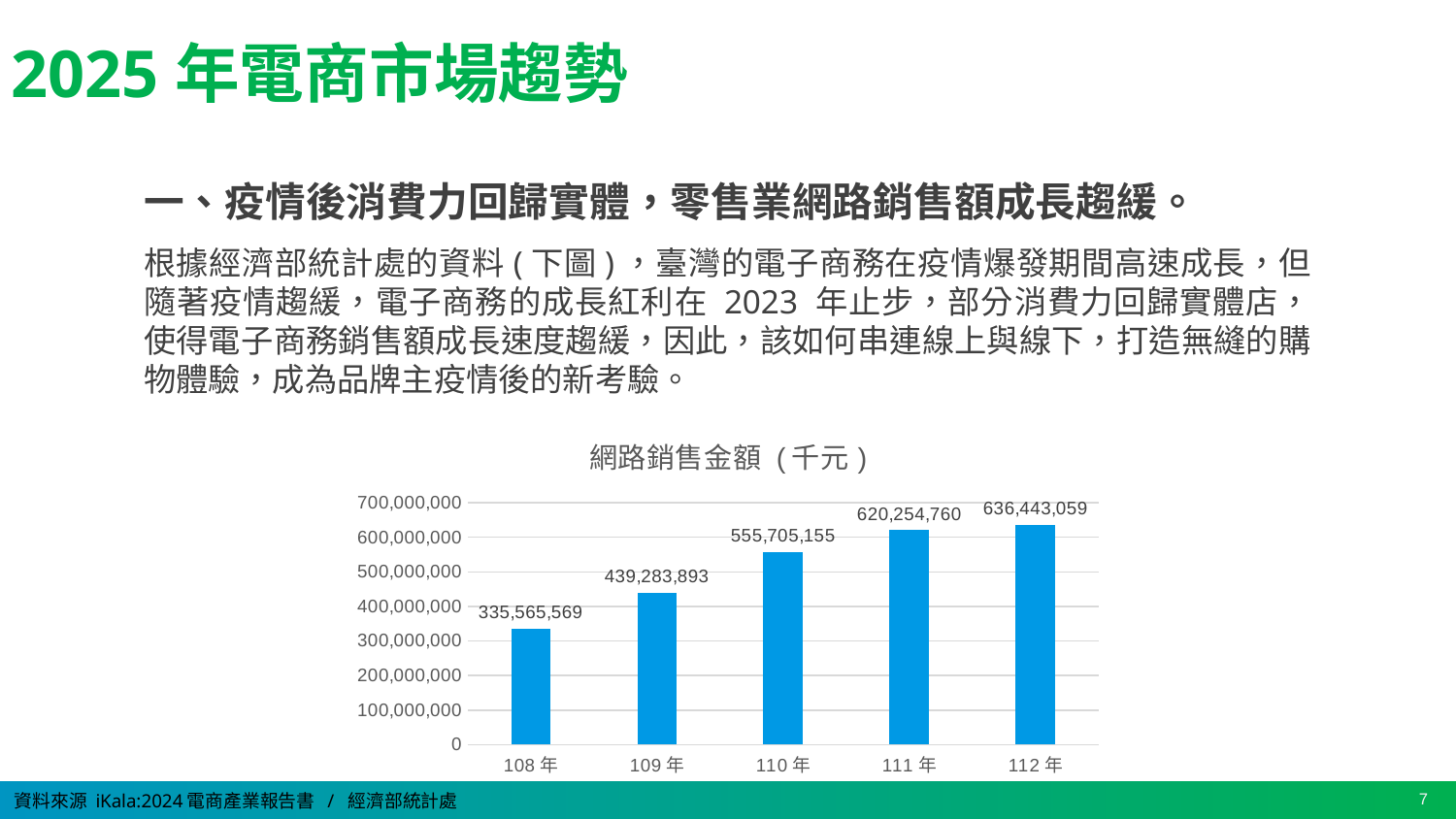
What is the value for 110 年 in the chart? 555,705,155 Is the value for 111 年 greater or less than 600,000,000? greater Which year has the highest value in the chart? 112 年 Which is larger, the value for 109 年 or the value for 110 年? 110 年 What is the difference between the values for 109 年 and 108 年? 103,718,324 What is the difference between the values for 112 年 and 111 年? 16,188,299 What is the value for 112 年 in the chart? 636,443,059 How many years are shown on the x axis of the chart? 5 What kind of chart is shown on the slide? bar chart Do the values rise or fall from 108 年 to 112 年? rise Which year has the lowest value in the chart? 108 年 What is the value for 108 年 in the chart? 335,565,569